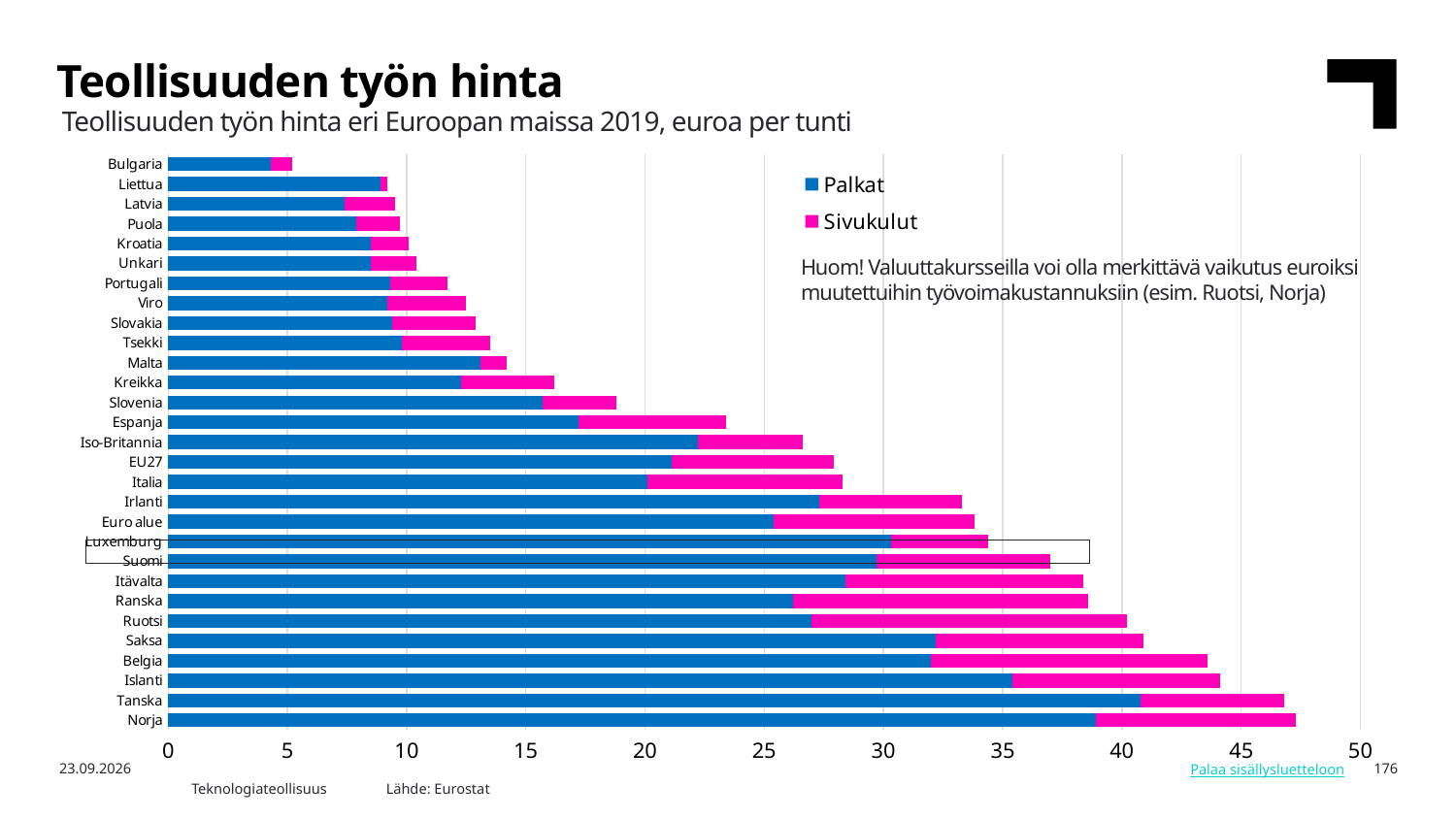
What is the source of the data cited on the slide? Eurostat How many countries or regions are shown on the chart? 29 Which has the larger total value, Liettua or Bulgaria? Liettua What are the two series named in the legend? Palkat and Sivukulut Is the total value for Belgia greater or less than 40? greater Is the total value for Norja greater or less than 45? greater Which has the larger total value, Tanska or Belgia? Tanska How many series does the legend list? 2 Is the total value for Bulgaria greater or less than 10? less Which country has the lowest total labour cost on the chart? Bulgaria What kind of chart is shown on the slide? Stacked bar chart